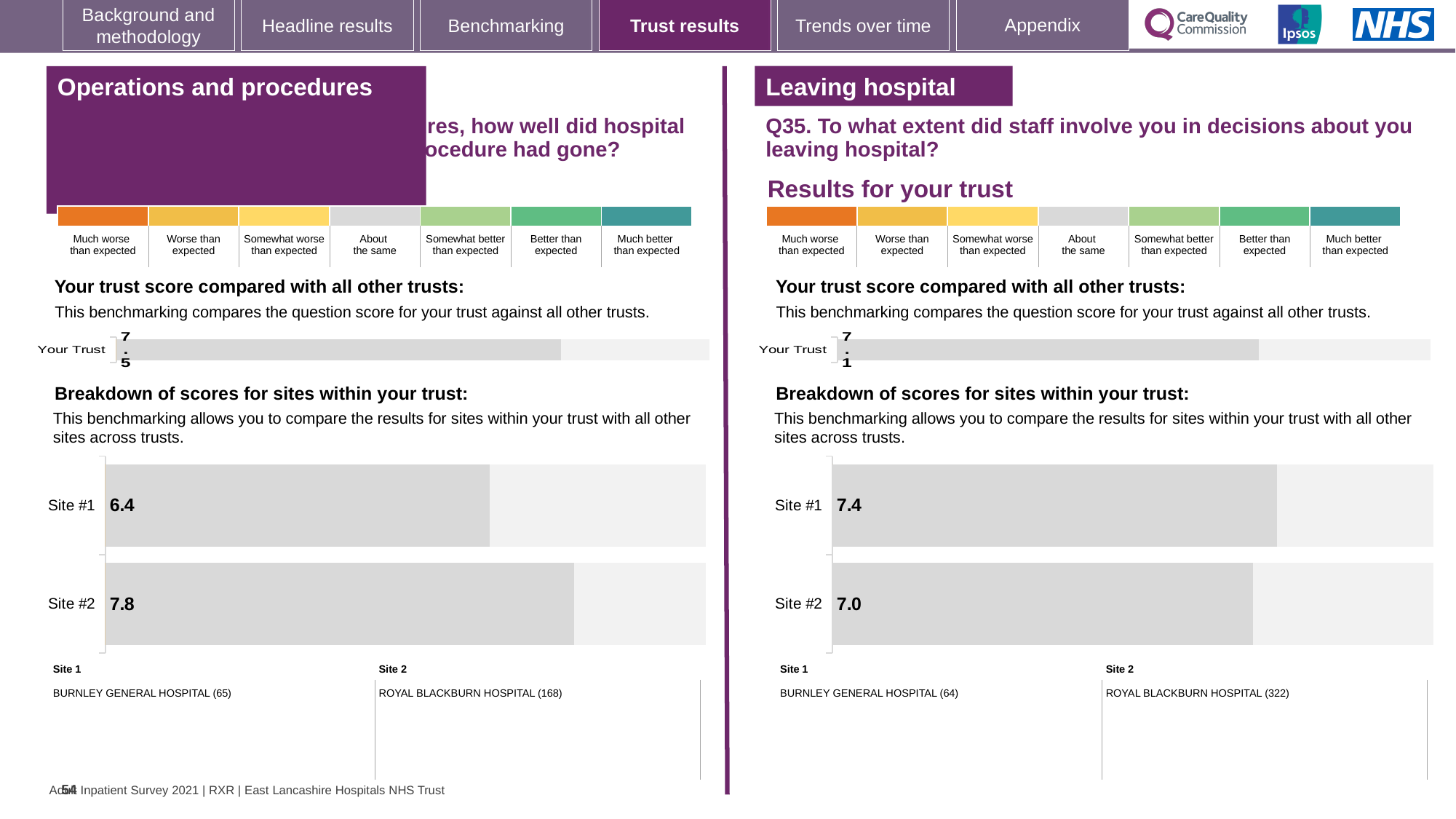
In the site breakdown chart under 'Operations and procedures' (left side), what is the difference between the Site #2 and Site #1 scores? 1.4 In the site breakdown chart under 'Operations and procedures' (left side), what is the score for Site #2? 7.8 In the 'Your trust score compared with all other trusts' chart under 'Operations and procedures' (left side), what is the score for Your Trust? 7.5 In the 'Breakdown of scores for sites within your trust' chart under 'Leaving hospital' (right side), what is the score for Site #1? 7.4 In the 'Breakdown of scores for sites within your trust' chart under 'Leaving hospital' (right side), what is the score for Site #2? 7.0 What type of chart is used for the site breakdown under 'Operations and procedures' (left side)? Bar chart In the site breakdown chart under 'Operations and procedures' (left side), which site has the higher score? Site #2 In the 'Your trust score compared with all other trusts' chart under 'Leaving hospital' (right side), what is the score for Your Trust? 7.1 How many sites are shown in the site breakdown chart under 'Leaving hospital' (right side)? 2 In the site breakdown chart under 'Leaving hospital' (right side), what is the difference between the Site #1 and Site #2 scores? 0.4 In the site breakdown chart under 'Operations and procedures' (left side), what is the score for Site #1? 6.4 In the site breakdown chart under 'Leaving hospital' (right side), which site has the lower score? Site #2